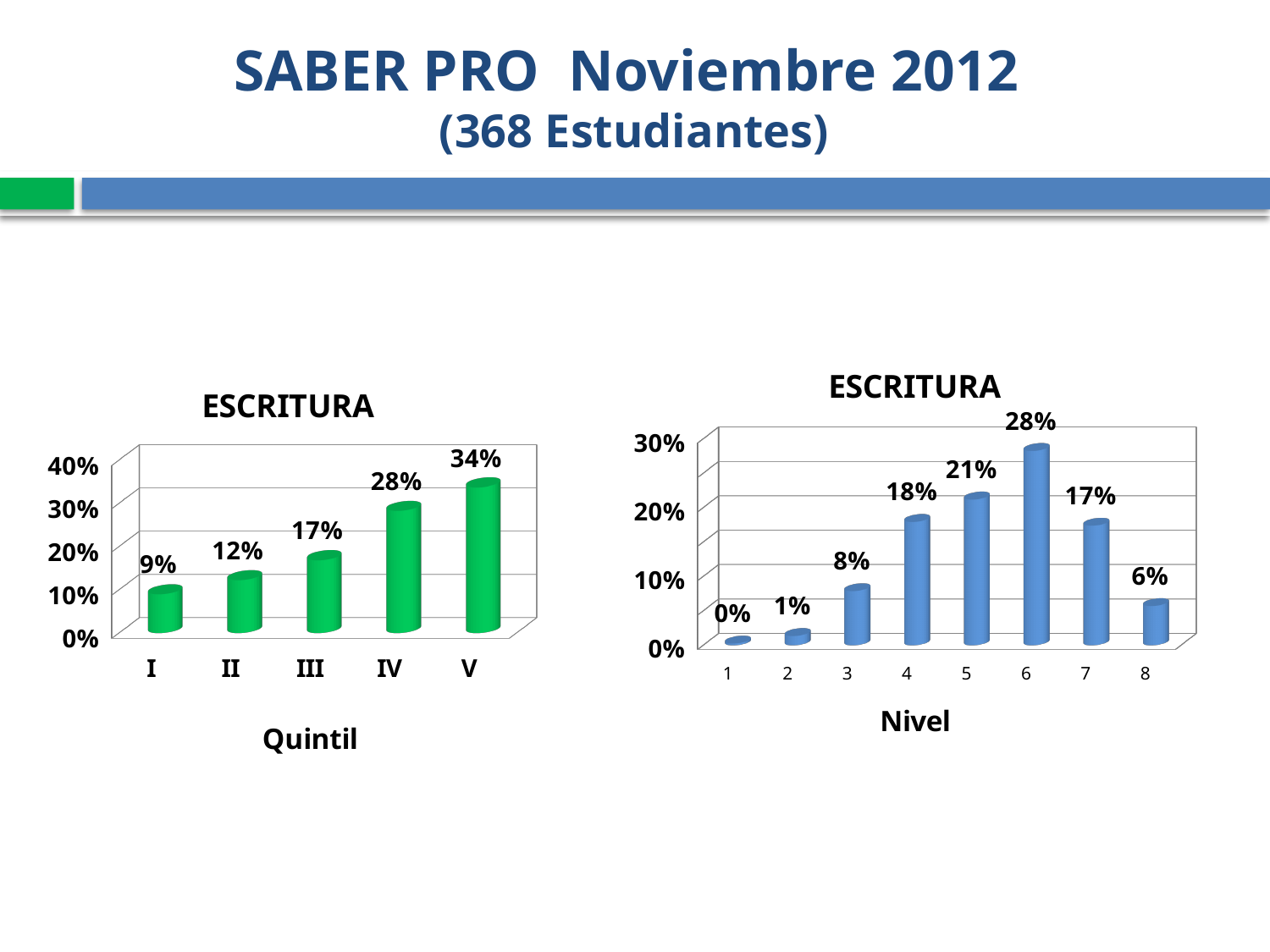
In the right chart (Nivel), which is larger, the value for level 5 or the value for level 7? level 5 In the left chart (Quintil), which quintile has the lowest value? I In the right chart (Nivel), which level has the highest value? 6 What kind of chart is the right chart (Nivel)? bar chart In the right chart (Nivel), what is the value for level 4? 18% In the left chart (Quintil), do the values rise or fall from quintile I to quintile V? rise In the left chart (Quintil), which quintile has the highest value? V In the left chart (Quintil), how many quintiles are shown? 5 In the left chart (Quintil), what is the value for quintile III? 17% In the right chart (Nivel), how many levels are shown on the x axis? 8 In the left chart (Quintil), what is the difference between the values for quintile V and quintile I? 25% In the right chart (Nivel), which level has the lowest value? 1